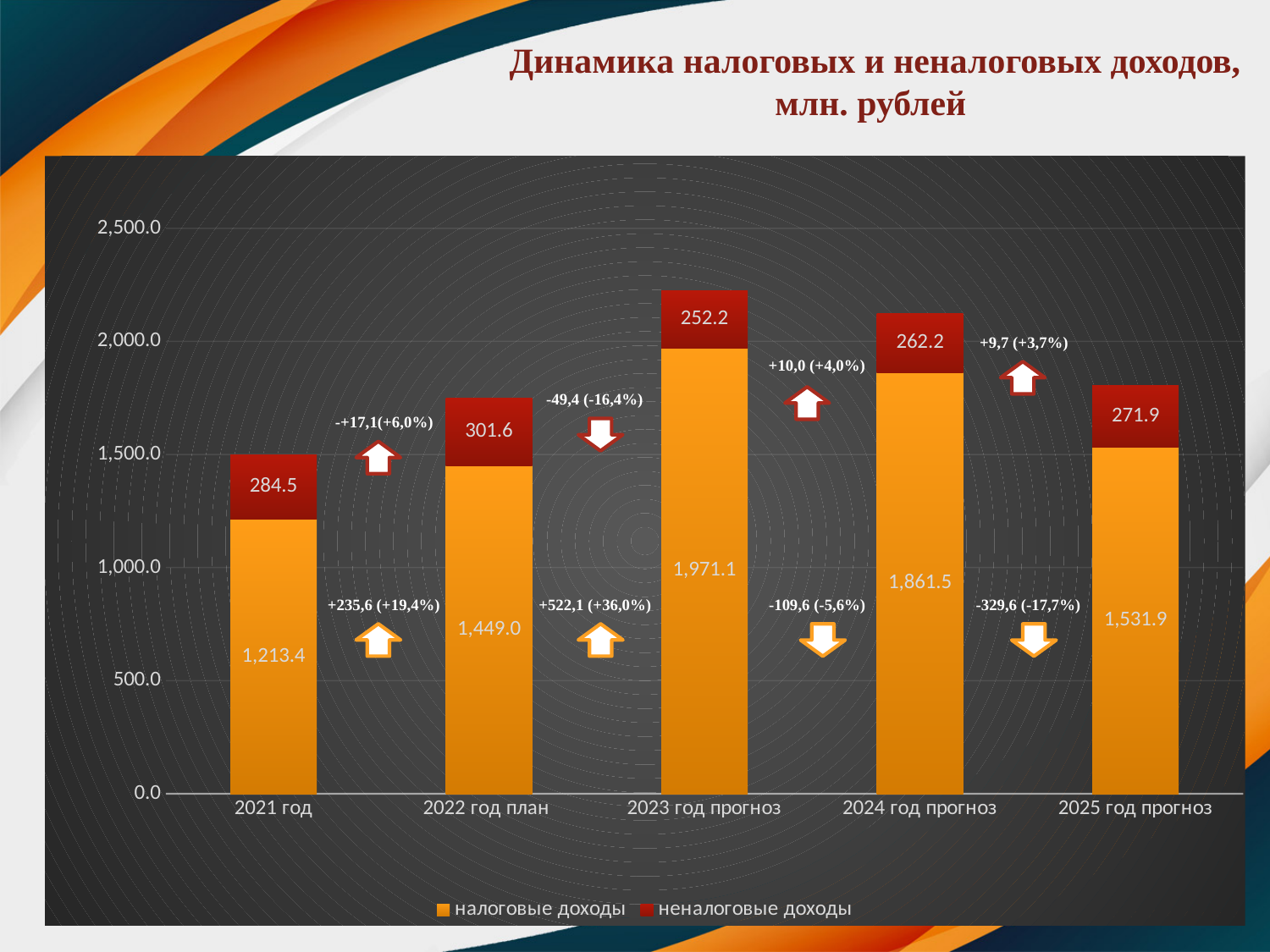
What is the total of the stacked bar for 2021 год? 1,497.9 What is the difference between налоговые доходы in 2023 год прогноз and 2024 год прогноз? 109.6 Which is larger: неналоговые доходы in 2022 год план or in 2025 год прогноз? 2022 год план What type of chart is shown on the slide? stacked bar chart How many categories are shown on the x axis? 5 What is the value of налоговые доходы for 2021 год? 1,213.4 In which year is the value of налоговые доходы the highest? 2023 год прогноз How many series does the legend list? 2 Which series is shown in dark red in the legend? неналоговые доходы In which year is the value of неналоговые доходы the lowest? 2023 год прогноз What is the value of налоговые доходы for 2025 год прогноз? 1,531.9 What is the value of неналоговые доходы for 2023 год прогноз? 252.2